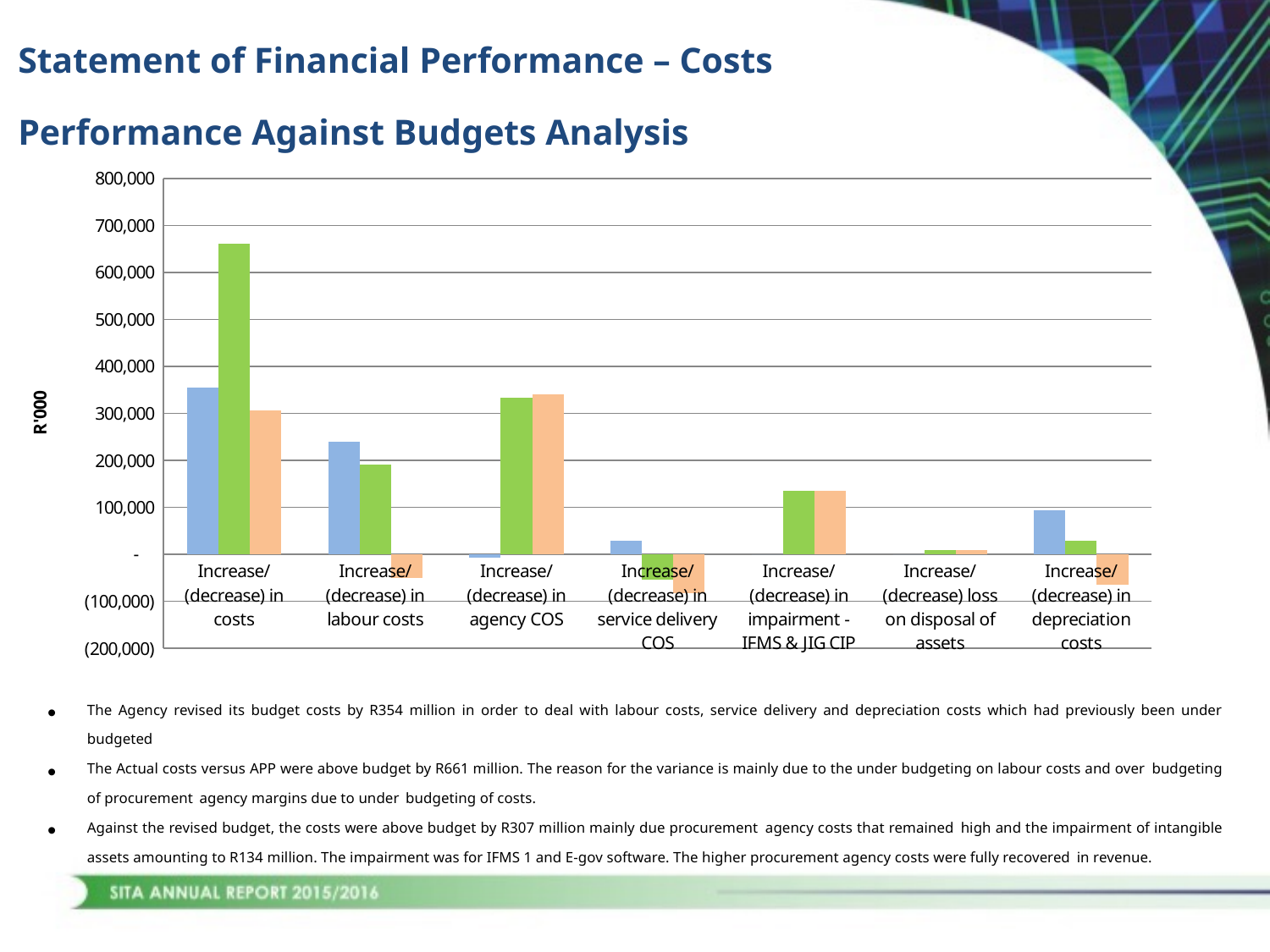
What kind of chart is shown on the slide? bar chart Which category contains the tallest bar in the chart? Increase/(decrease) in costs Which is larger: the blue bar for 'Increase/(decrease) in costs' or the blue bar for 'Increase/(decrease) in labour costs'? Increase/(decrease) in costs How many bars are plotted for each category in the chart? 3 How many categories are shown along the x axis of the chart? 7 Is the green bar for 'Increase/(decrease) in impairment - IFMS & JIG CIP' greater or less than 100,000? greater Is the green bar for 'Increase/(decrease) in agency COS' greater or less than 300,000? greater Is the green bar for 'Increase/(decrease) in costs' greater or less than 600,000? greater What is the label on the vertical axis of the chart? R'000 Which is larger: the green bar for 'Increase/(decrease) in costs' or the green bar for 'Increase/(decrease) in agency COS'? Increase/(decrease) in costs